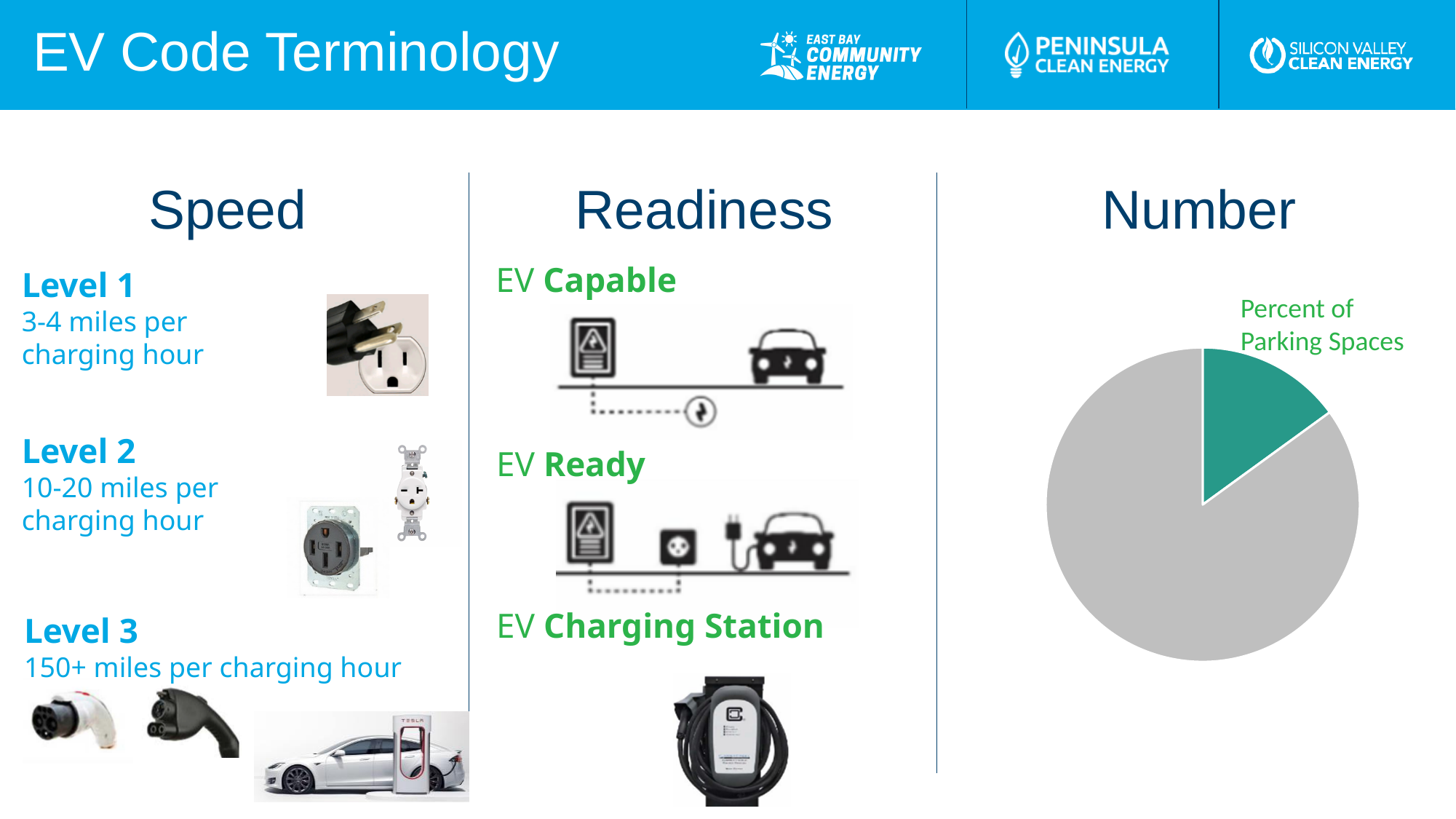
What colour is the smaller slice of the pie chart? green Which slice of the pie chart is the smallest? the green slice Which slice of the pie chart is larger, the green one or the grey one? the grey one What kind of chart is shown under the "Number" heading? pie chart How many slices does the pie chart have? 2 Which slice of the pie chart is the largest? the grey slice What is the title of the pie chart? Percent of Parking Spaces